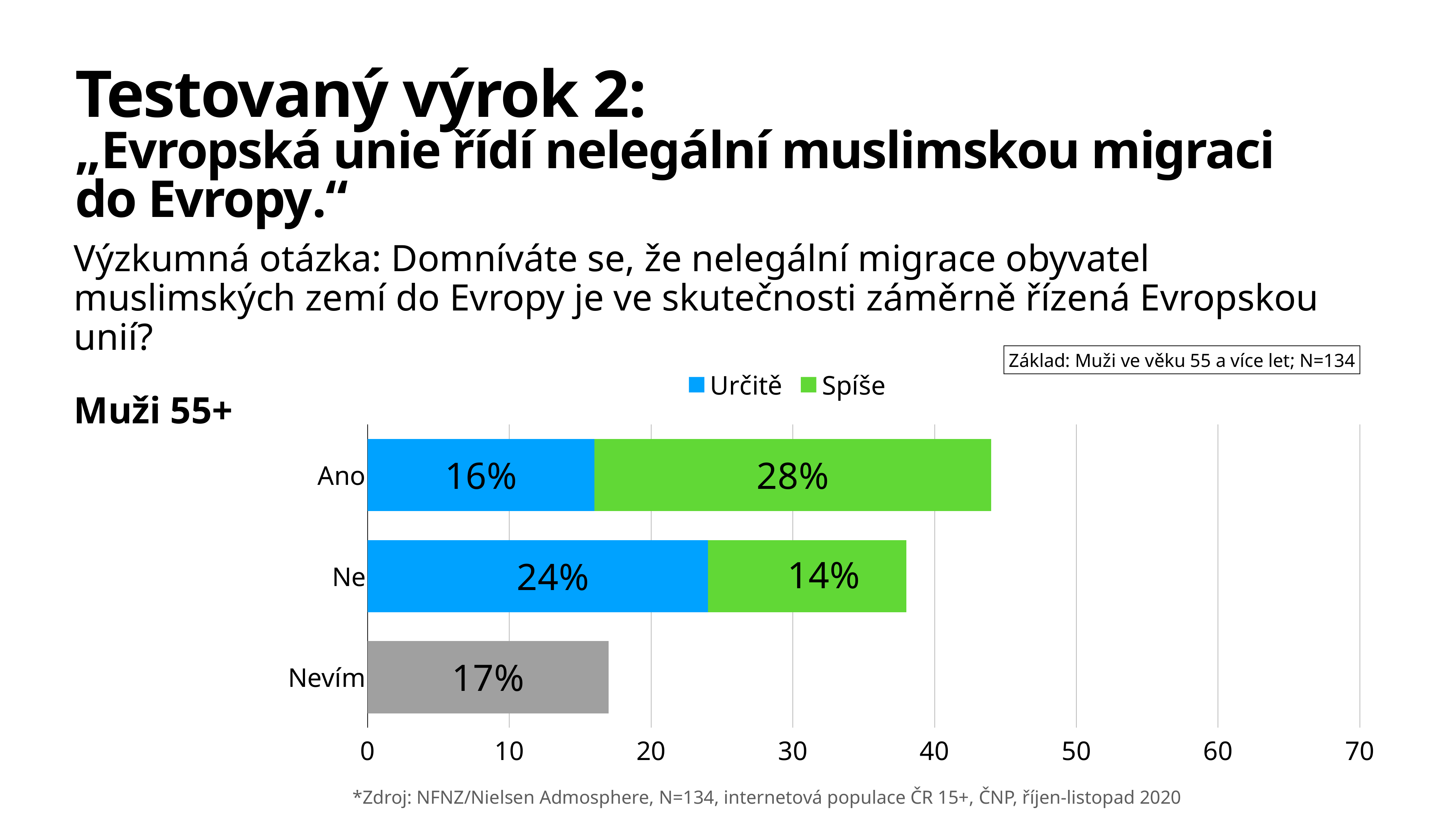
What is the difference between the Určitě values for Ne and Ano? 8% Which is larger: the Spíše value for Ano or the Spíše value for Ne? Ano What is the total of the stacked bar for the Ano category? 44% How many categories are shown on the y axis of the chart? 3 How many series does the legend list? 2 What kind of chart is shown on the slide? Bar chart What is the total of the stacked bar for the Ne category? 38% Which category has the lowest Určitě value? Ano Which category has the highest Spíše value? Ano What is the value of the Spíše series for the Ne category? 14% What is the value of the Určitě series for the Ano category? 16% What is the value shown for the Nevím category? 17%